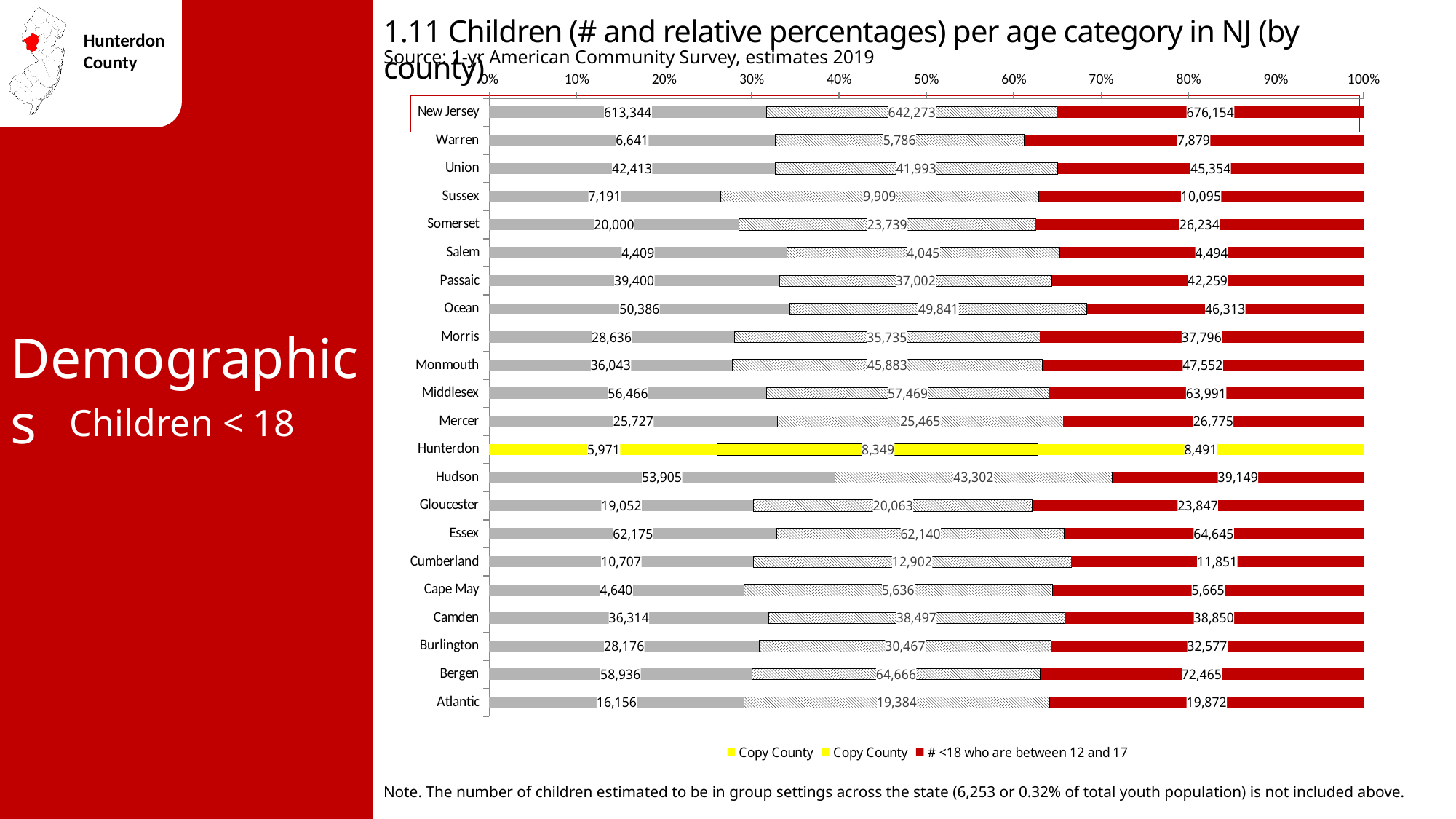
How many categories (rows) are plotted on the chart? 22 Which has a larger leftmost segment value, Hudson or Ocean? Hudson What is the total of the three segments for Hunterdon? 22,811 How many series does the legend list? 3 What type of chart is shown on the slide? Stacked bar chart What is the value of the middle segment for Sussex? 9,909 What is the value of the '# <18 who are between 12 and 17' segment for Hunterdon? 8,491 What is the value of the '# <18 who are between 12 and 17' segment for New Jersey? 676,154 Among the counties (excluding the New Jersey row), which has the highest '# <18 who are between 12 and 17' value? Bergen What is the difference between the '# <18 who are between 12 and 17' values for Bergen and Atlantic? 52,593 Which row is highlighted in yellow on the chart? Hunterdon What is the value of the leftmost segment for Hunterdon? 5,971